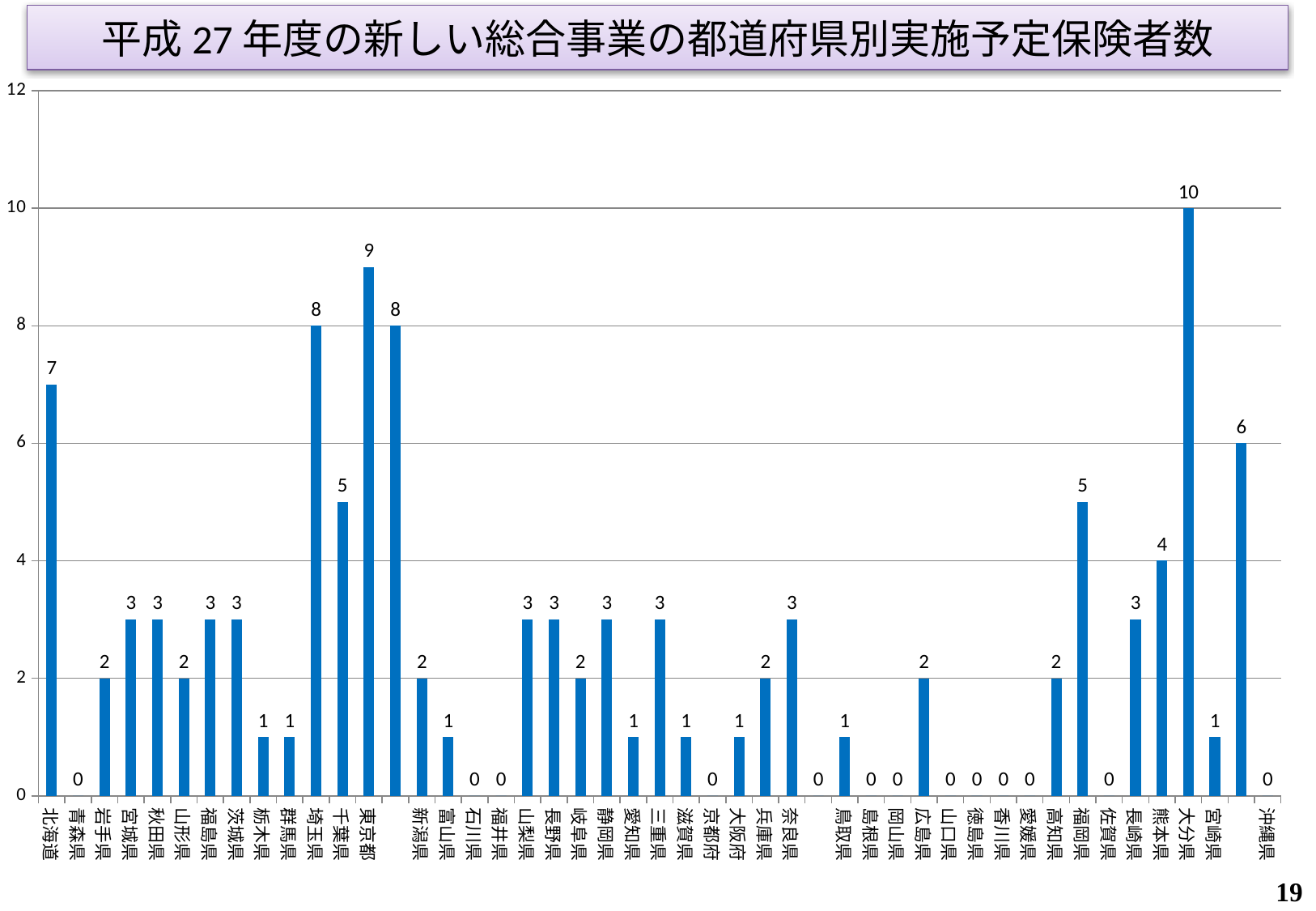
What is the difference between the values for 大分県 and 熊本県? 6 What is the value for 福岡県? 5 Which prefecture has the highest value? 大分県 What is the value for 大分県? 10 What is the value for 埼玉県? 8 What is the value for 北海道? 7 What is the value for 東京都? 9 Which is larger, the value for 北海道 or the value for 埼玉県? 埼玉県 What kind of chart is shown on the slide? bar chart Which is larger, the value for 福岡県 or the value for 長崎県? 福岡県 What is the difference between the values for 東京都 and 千葉県? 4 What is the value for 青森県? 0